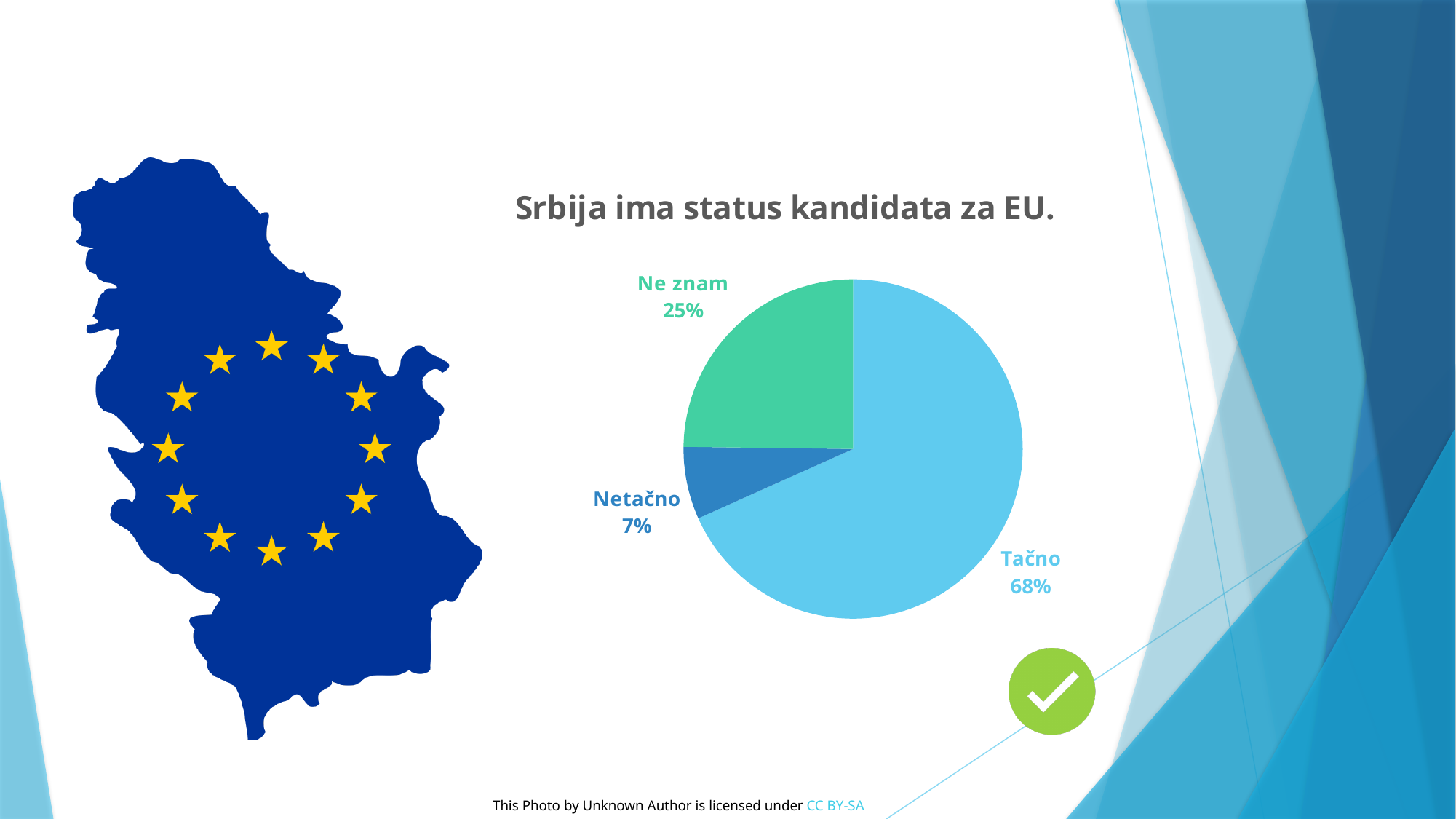
Which slice of the pie is the largest? Tačno What percentage of the pie is labelled Tačno? 68% What type of chart is shown on the slide? pie chart What percentage of the pie is labelled Netačno? 7% Which slice of the pie is the smallest? Netačno How many slices does the pie chart have? 3 What percentage of the pie is labelled Ne znam? 25% What is the title of the chart? Srbija ima status kandidata za EU. What colour is the Ne znam slice of the pie? green Which is larger, the Ne znam slice or the Netačno slice? Ne znam What is the difference in percentage points between the Tačno and Ne znam slices? 43 What is the difference in percentage points between the Ne znam and Netačno slices? 18